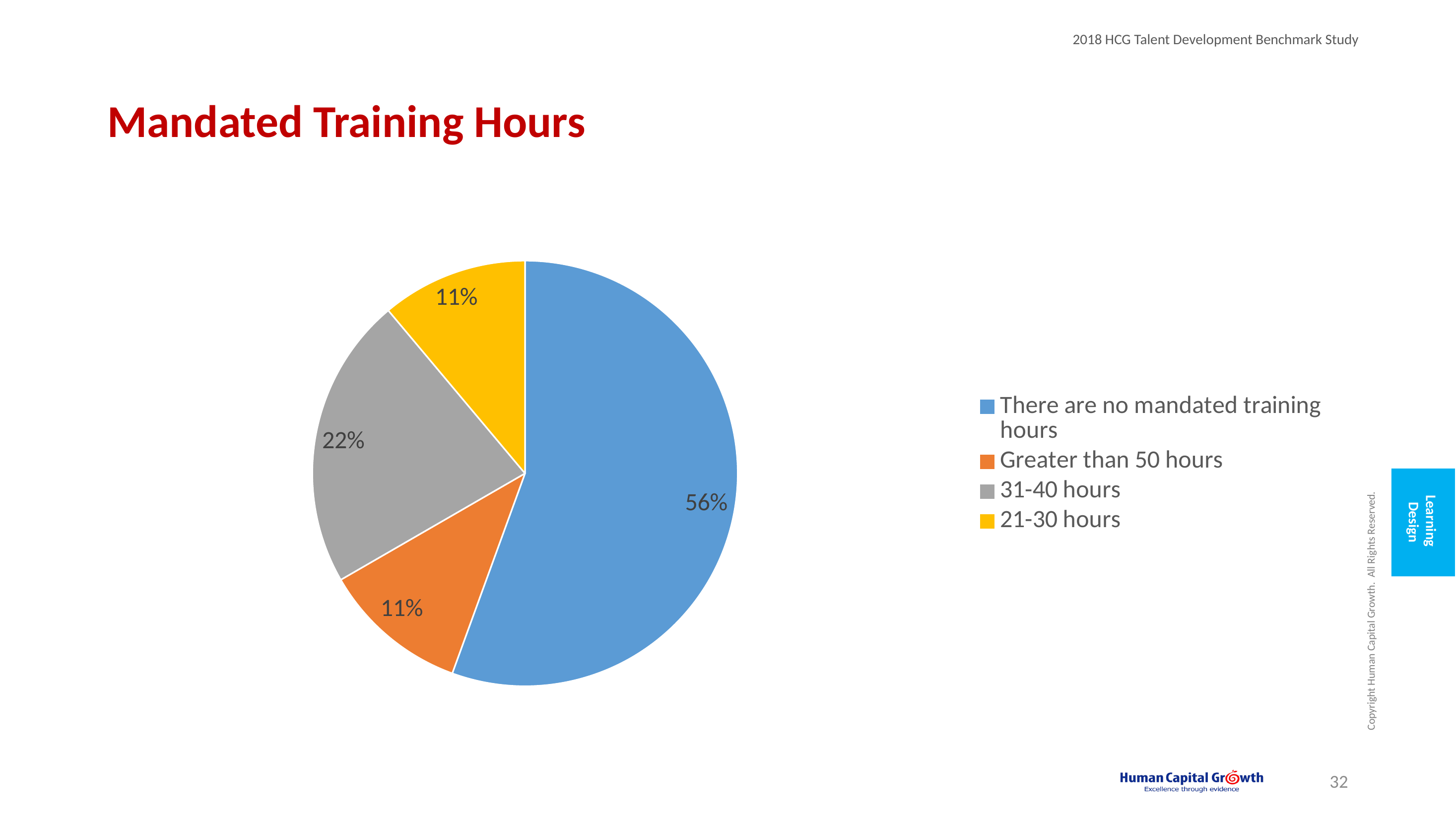
What colour is the slice for '21-30 hours'? Yellow What share of the pie is labelled 'There are no mandated training hours'? 56% What share of the pie is labelled '21-30 hours'? 11% What share of the pie is labelled 'Greater than 50 hours'? 11% Which is larger, the share for '31-40 hours' or the share for 'Greater than 50 hours'? 31-40 hours What is the title of the slide containing the pie chart? Mandated Training Hours How many slices does the pie chart have? 4 Which category has the largest slice of the pie? There are no mandated training hours What is the difference between the share for 'There are no mandated training hours' and the share for '31-40 hours'? 34% What kind of chart is shown on the slide? Pie chart How many entries does the legend list? 4